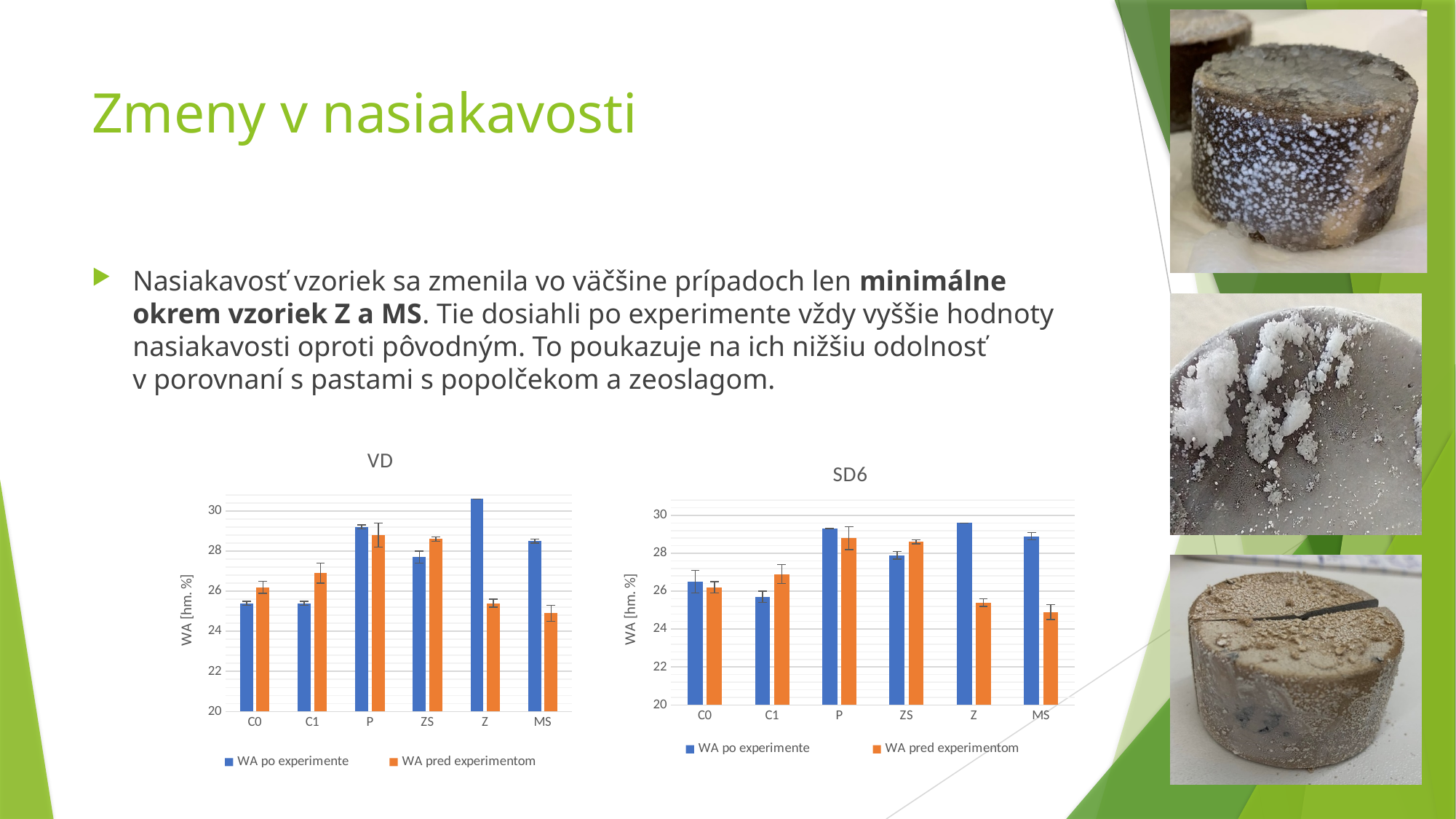
In the SD6 chart, is the WA po experimente value for Z greater or less than 28? greater What is the y-axis label of the SD6 chart? WA [hm. %] In the SD6 chart, is the WA pred experimentom value for MS greater or less than 26? less In the VD chart, is the WA po experimente value for Z greater or less than 30? greater In the VD chart, which category has the highest value for WA po experimente? Z How many series does the legend of the VD chart list? 2 How many categories are shown on the x axis of the SD6 chart? 6 In the SD6 chart, for category MS, which series has the larger value: WA po experimente or WA pred experimentom? WA po experimente What kind of chart is the VD chart? bar chart In the VD chart, for category Z, which series has the larger value: WA po experimente or WA pred experimentom? WA po experimente